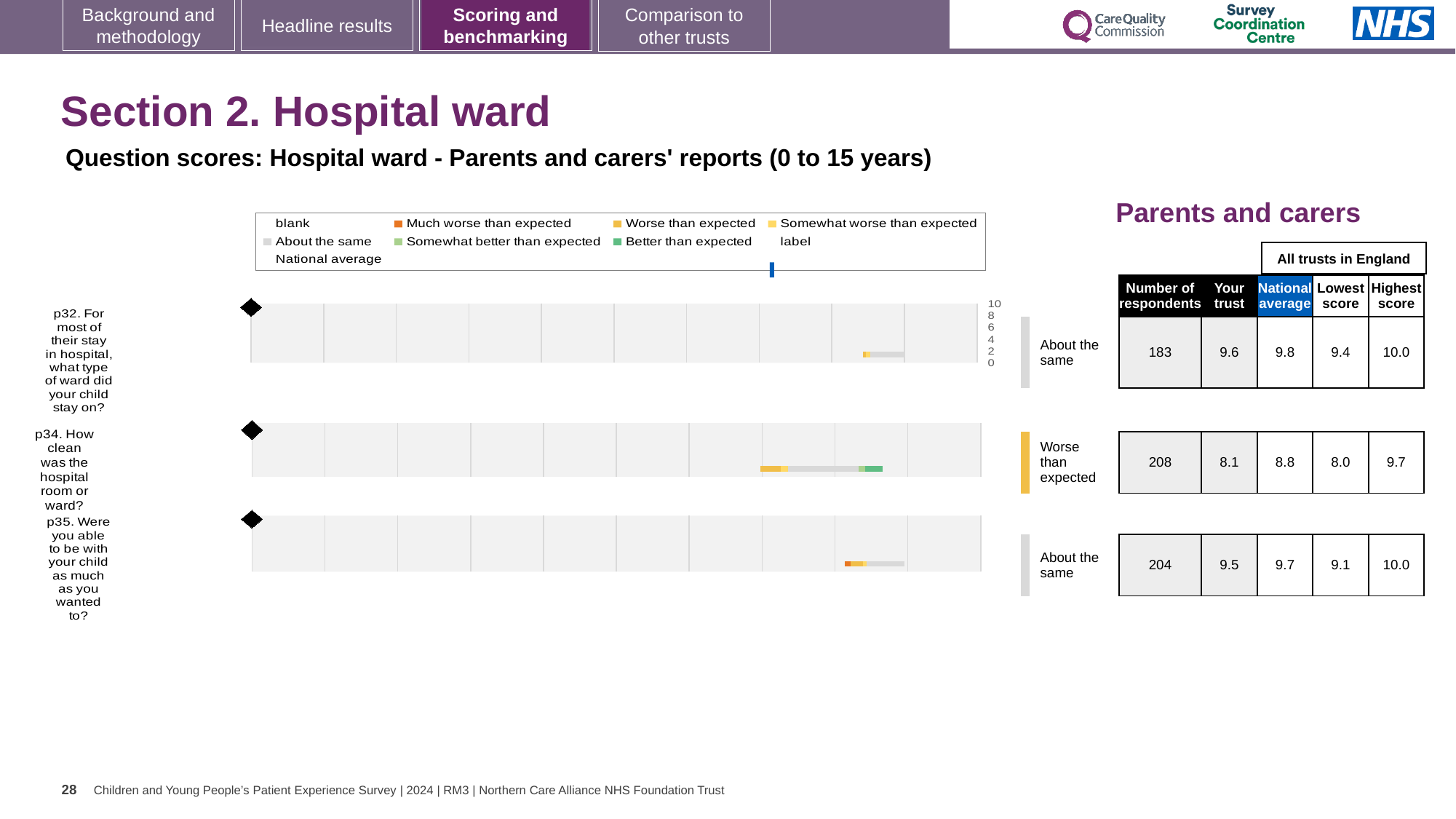
Which question has the highest number of respondents? p34 What is the highest score among all trusts in England for p34? 9.7 For p34, what is the difference between the national average and the 'Your trust' score? 0.7 How many respondents answered p32 (what type of ward did your child stay on)? 183 What is the 'Your trust' score for p34 (How clean was the hospital room or ward?)? 8.1 What is the national average score for p35 (Were you able to be with your child as much as you wanted to)? 9.7 What benchmark category is shown for p34 (How clean was the hospital room or ward?)? Worse than expected How many questions (categories) are plotted in the chart? 3 Which has the higher 'Your trust' score, p32 or p35? p32 What kind of chart is used to show the question scores on this slide? Bar chart Which question has the lowest 'Your trust' score? p34 What is the title of the chart on this slide? Question scores: Hospital ward - Parents and carers' reports (0 to 15 years)